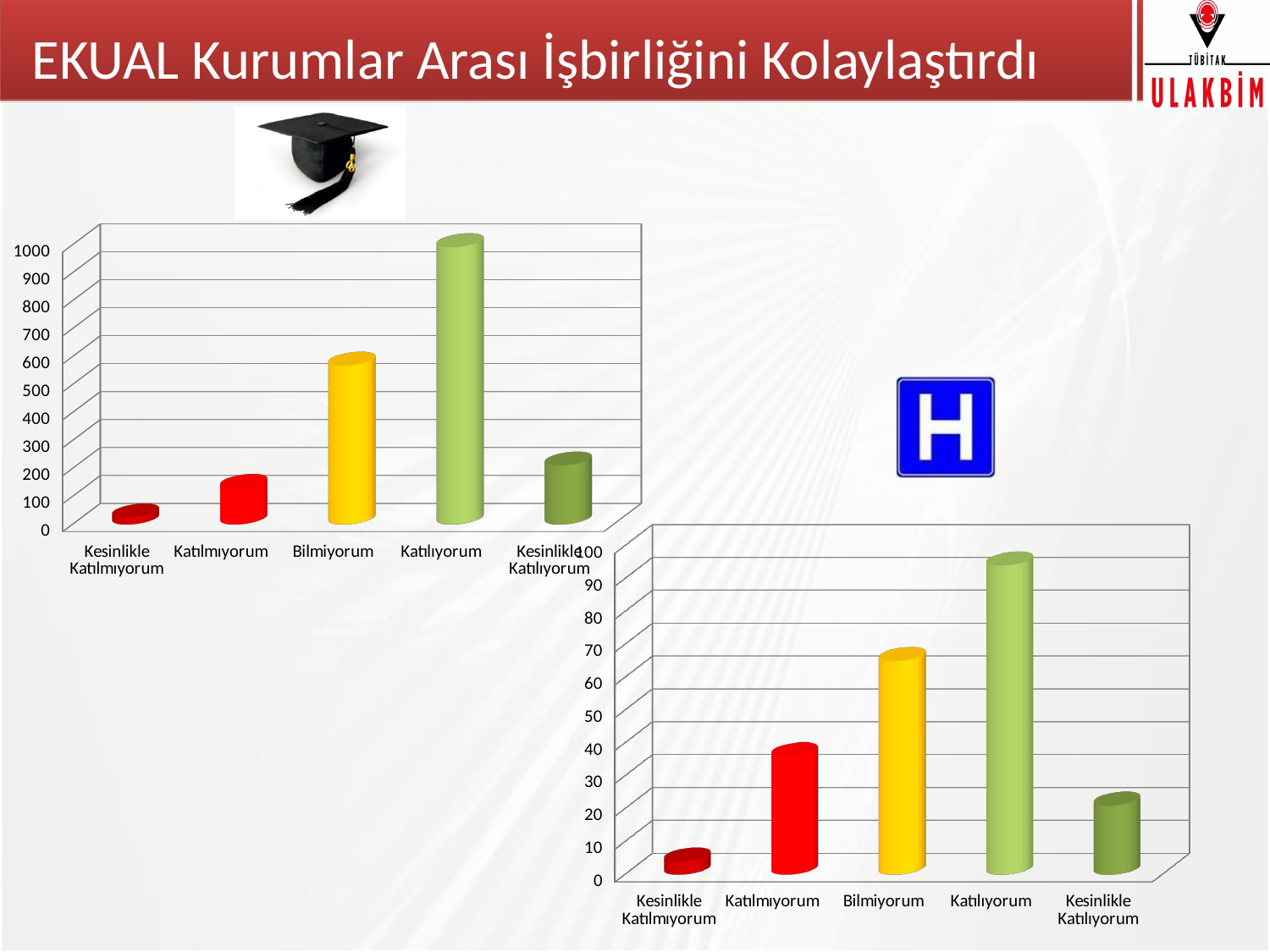
In the top-left chart (next to the graduation cap), which category has the lowest value? Kesinlikle Katılmıyorum What type of chart is the top-left chart (next to the graduation cap)? bar chart In the top-left chart (next to the graduation cap), which is larger: the value for Katılmıyorum or the value for Kesinlikle Katılıyorum? Kesinlikle Katılıyorum In the bottom-right chart (next to the hospital sign), is the value for Katılmıyorum greater or less than 30? greater In the bottom-right chart (next to the hospital sign), which is larger: the value for Bilmiyorum or the value for Kesinlikle Katılıyorum? Bilmiyorum In the top-left chart (next to the graduation cap), which category has the highest value? Katılıyorum How many categories are shown on the x axis of the bottom-right chart (next to the hospital sign)? 5 In the top-left chart (next to the graduation cap), is the value for Kesinlikle Katılıyorum greater or less than 300? less In the bottom-right chart (next to the hospital sign), which category has the highest value? Katılıyorum In the bottom-right chart (next to the hospital sign), which category has the lowest value? Kesinlikle Katılmıyorum In the top-left chart (next to the graduation cap), is the value for Bilmiyorum greater or less than 500? greater